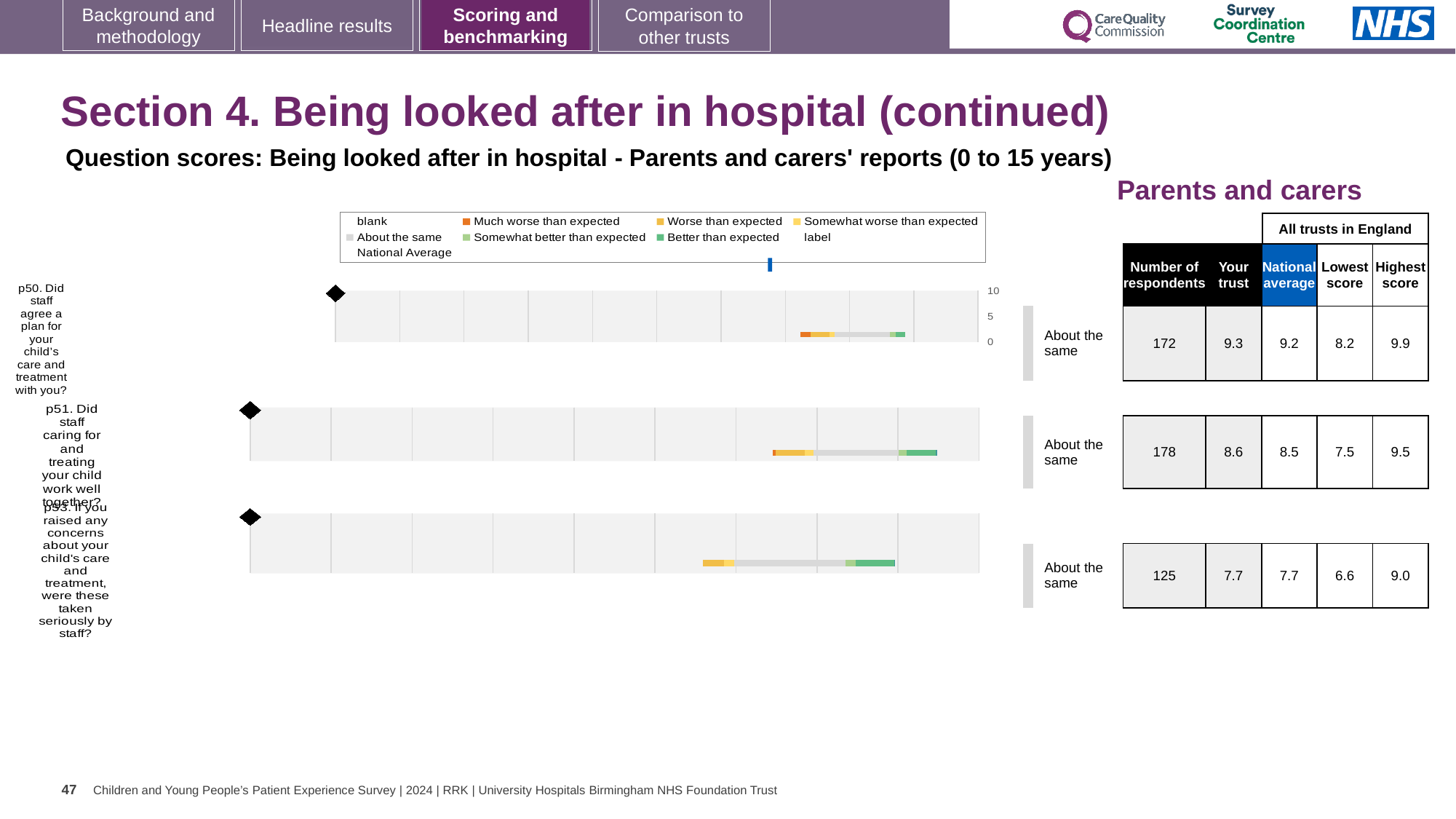
What is the national average score for p51 (Did staff caring for and treating your child work well together?)? 8.5 What is the 'Your trust' score for p50 (Did staff agree a plan for your child's care and treatment with you?)? 9.3 What is the difference between the highest and lowest scores among all trusts in England for p51? 2.0 How many respondents answered p53 (If you raised any concerns about your child's care and treatment, were these taken seriously by staff?)? 125 Which question has the fewest respondents on this slide? p53 Which question has the highest 'Your trust' score on this slide? p50 How many questions are charted on this slide? 3 What is the lowest score among all trusts in England for p53? 6.6 Which has the larger 'Your trust' score, p51 or p53? p51 What is the highest score among all trusts in England for p50? 9.9 What benchmark category is shown for p51? About the same What is the difference between the 'Your trust' score and the national average for p50? 0.1